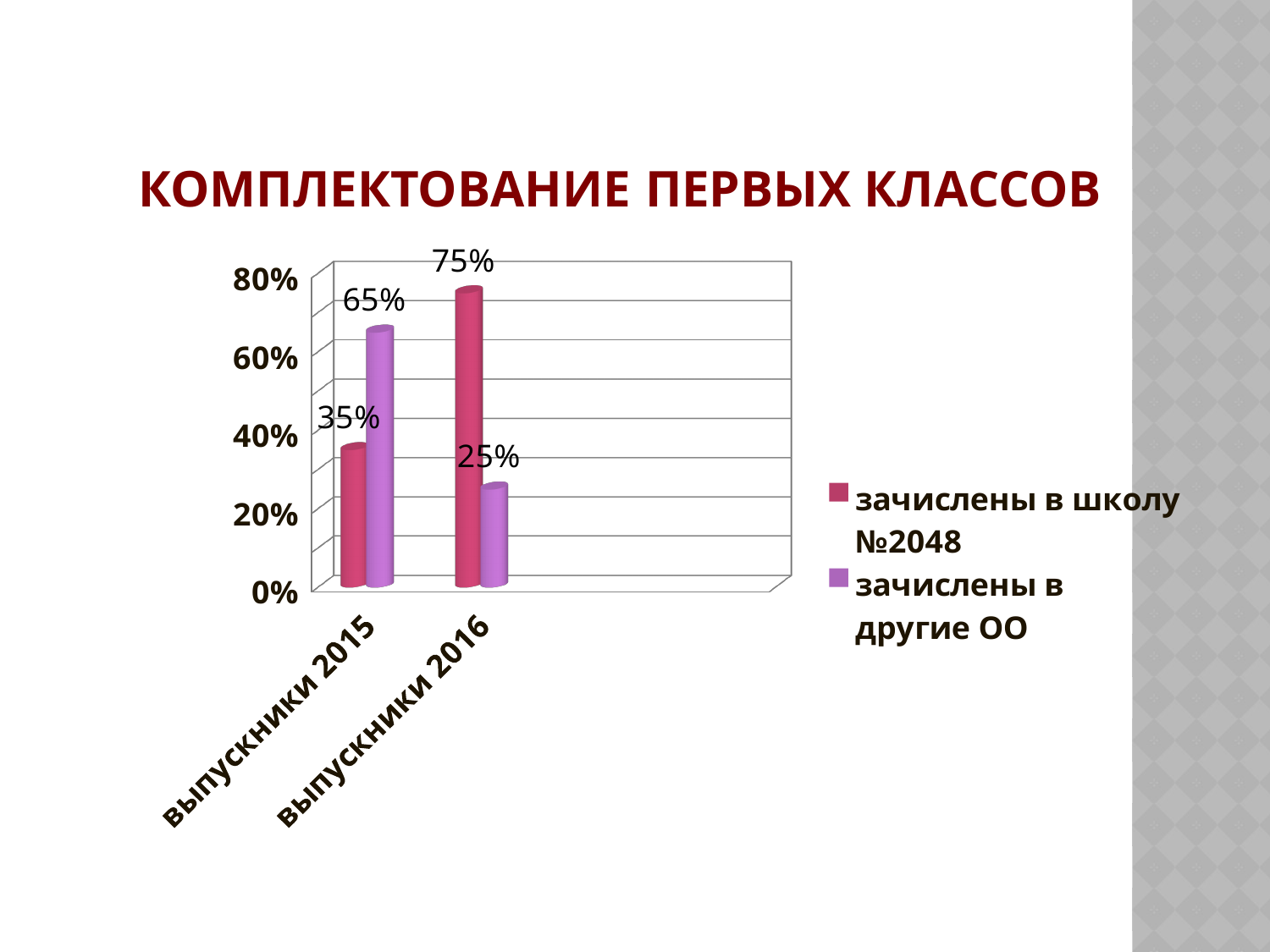
What percentage of выпускники 2015 were зачислены в школу №2048? 35% Which category has the lowest value for зачислены в другие ОО? выпускники 2016 What kind of chart is shown on the slide? bar chart What percentage of выпускники 2016 were зачислены в школу №2048? 75% What percentage of выпускники 2015 were зачислены в другие ОО? 65% What percentage of выпускники 2016 were зачислены в другие ОО? 25% Which category has the highest value for зачислены в школу №2048? выпускники 2016 How many categories are shown on the x axis? 2 What is the difference between зачислены в школу №2048 for выпускники 2016 and for выпускники 2015? 40% For выпускники 2015, which is larger: зачислены в школу №2048 or зачислены в другие ОО? зачислены в другие ОО What is the title of the slide? КОМПЛЕКТОВАНИЕ ПЕРВЫХ КЛАССОВ How many series does the legend list? 2